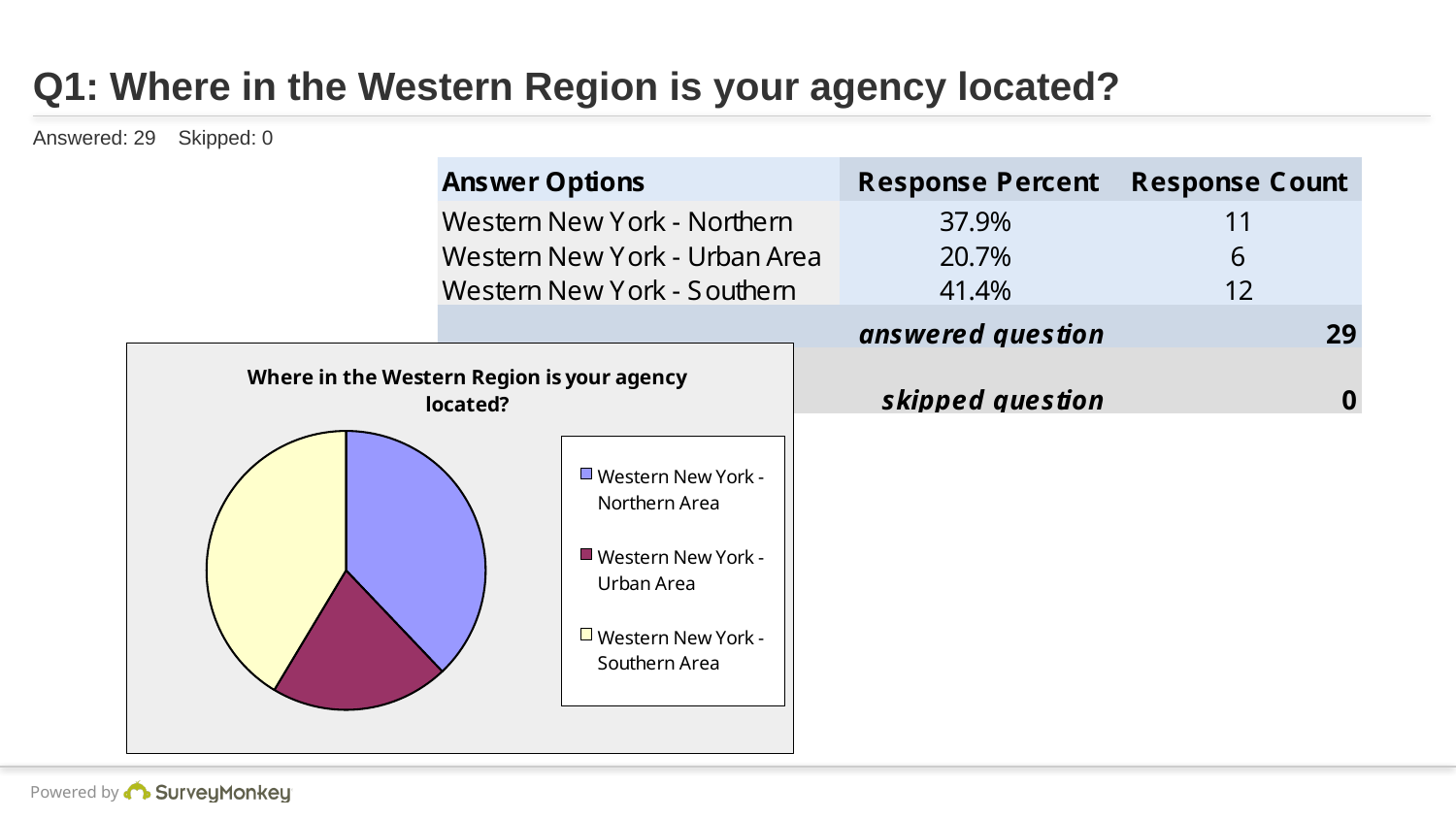
Which answer option has the lowest response count? Western New York - Urban Area What is the difference in response count between Western New York - Southern and Western New York - Northern? 1 How many entries does the pie chart's legend list? 3 What is the response percent for Western New York - Southern? 41.4% What is the title of the pie chart? Where in the Western Region is your agency located? Which answer option has the highest response count? Western New York - Southern How many slices does the pie chart have? 3 What is the response percent for Western New York - Northern? 37.9% What share of the pie does Western New York - Urban Area represent? 20.7% What kind of chart is shown on the slide? pie chart Which colour represents Western New York - Urban Area in the pie chart? purple What is the response count for Western New York - Urban Area? 6